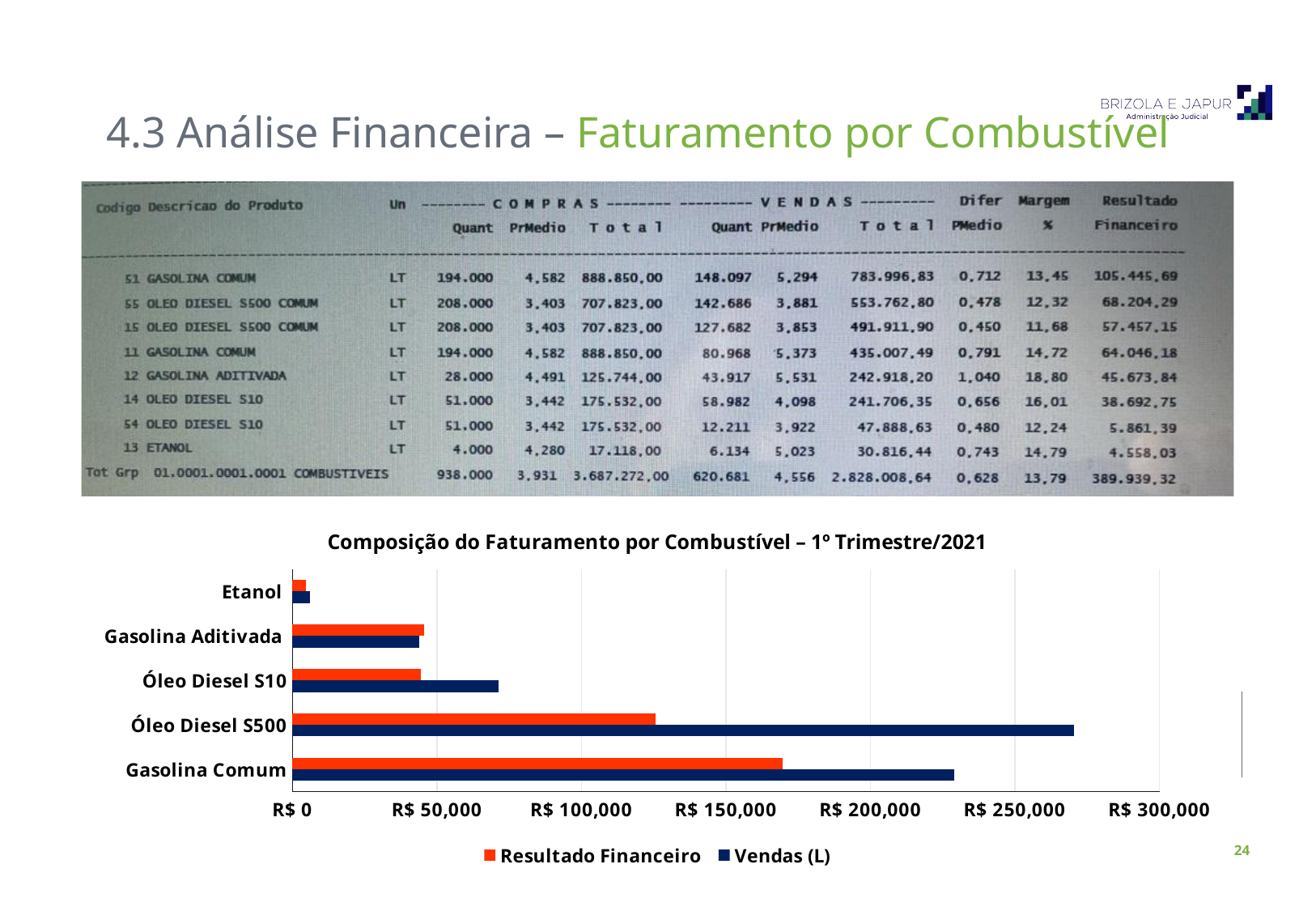
What kind of chart is shown on the slide? bar chart Which fuel has the highest Resultado Financeiro value in the chart? Gasolina Comum Which fuel has the lowest Vendas (L) value in the chart? Etanol Which fuel has the highest Vendas (L) value in the chart? Óleo Diesel S500 How many fuel categories are plotted in the chart? 5 Is the Vendas (L) value for Óleo Diesel S10 greater or less than R$ 100,000? less What is the title of the chart? Composição do Faturamento por Combustível – 1º Trimestre/2021 Which fuel has the lowest Resultado Financeiro value in the chart? Etanol Is the Resultado Financeiro value for Gasolina Comum greater or less than R$ 150,000? greater How many series does the chart legend list? 2 Is the Vendas (L) value for Óleo Diesel S500 greater or less than R$ 250,000? greater For Óleo Diesel S500, which is larger: Resultado Financeiro or Vendas (L)? Vendas (L)